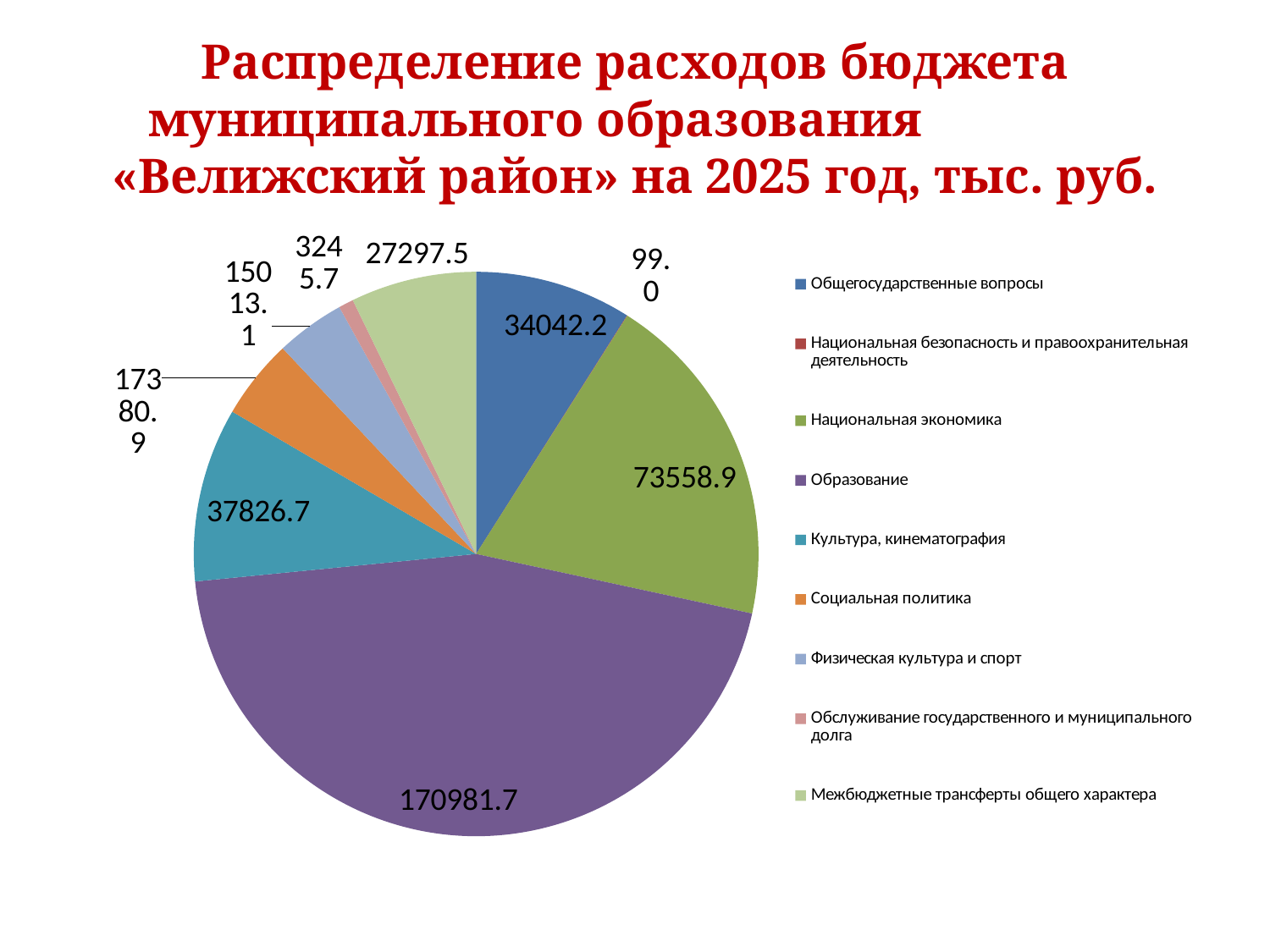
What is the value for Образование? 170981.7 What is the value for Общегосударственные вопросы? 34042.2 What kind of chart is shown on the slide? Pie chart What is the value for Межбюджетные трансферты общего характера? 27297.5 What is the difference between the values for Образование and Национальная экономика? 97422.8 What is the difference between the values for Национальная экономика and Культура, кинематография? 35732.2 Which category has the largest slice of the pie? Образование Which is larger, the value for Культура, кинематография or the value for Общегосударственные вопросы? Культура, кинематография What is the value for Национальная экономика? 73558.9 How many categories does the legend list? 9 Which category has the smallest slice of the pie? Национальная безопасность и правоохранительная деятельность What is the value for Культура, кинематография? 37826.7